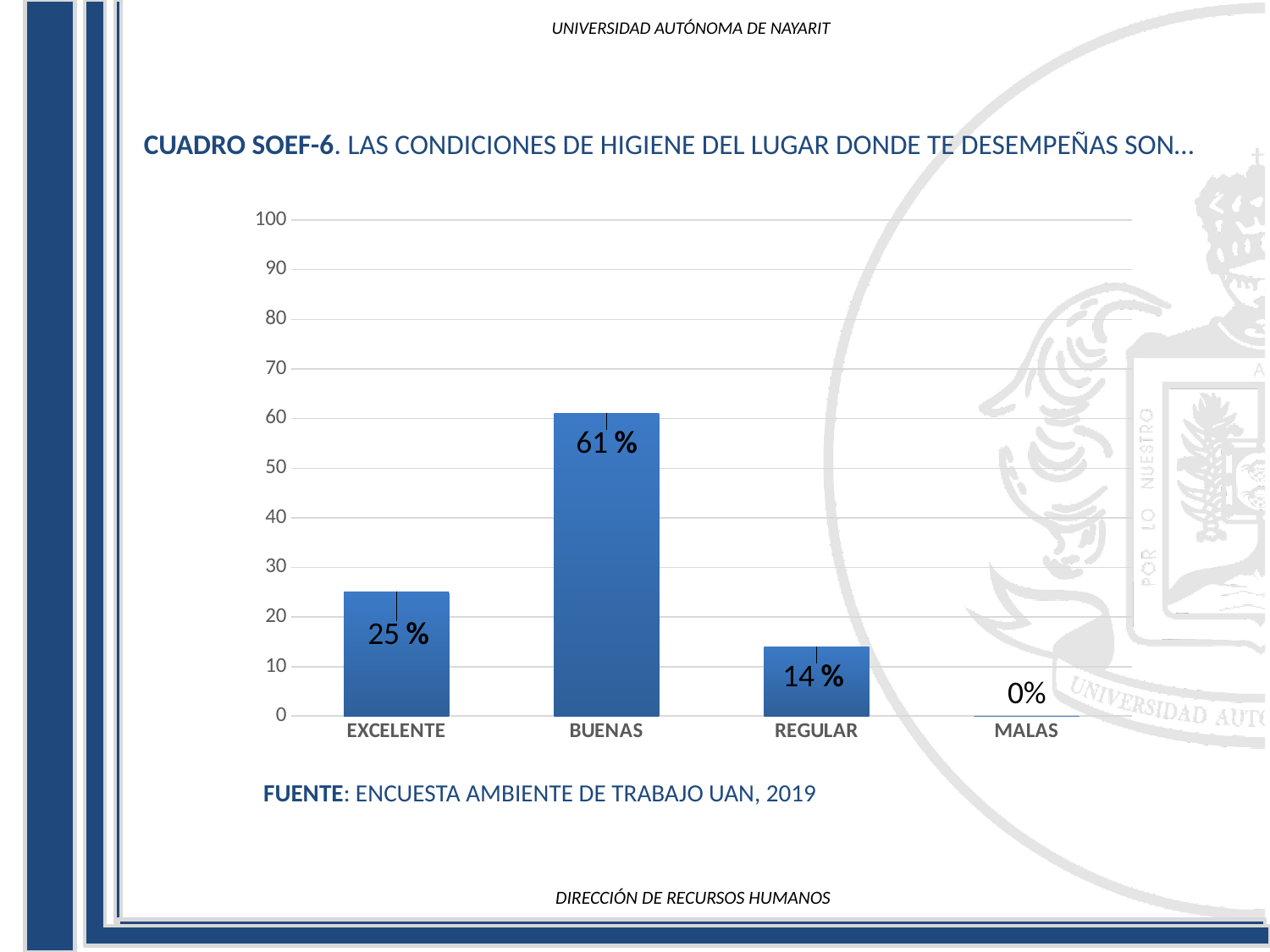
Is the value for BUENAS greater or less than 50? greater Which category has the highest value? BUENAS What is the source cited below the chart? ENCUESTA AMBIENTE DE TRABAJO UAN, 2019 Which is larger, the value for EXCELENTE or the value for REGULAR? EXCELENTE What is the difference between the values for BUENAS and EXCELENTE? 36 % How many categories are shown on the x axis? 4 What is the value for BUENAS? 61 % What kind of chart is shown on the slide? bar chart Which category has the lowest value? MALAS What is the value for EXCELENTE? 25 % What is the value for REGULAR? 14 % What is the value for MALAS? 0%